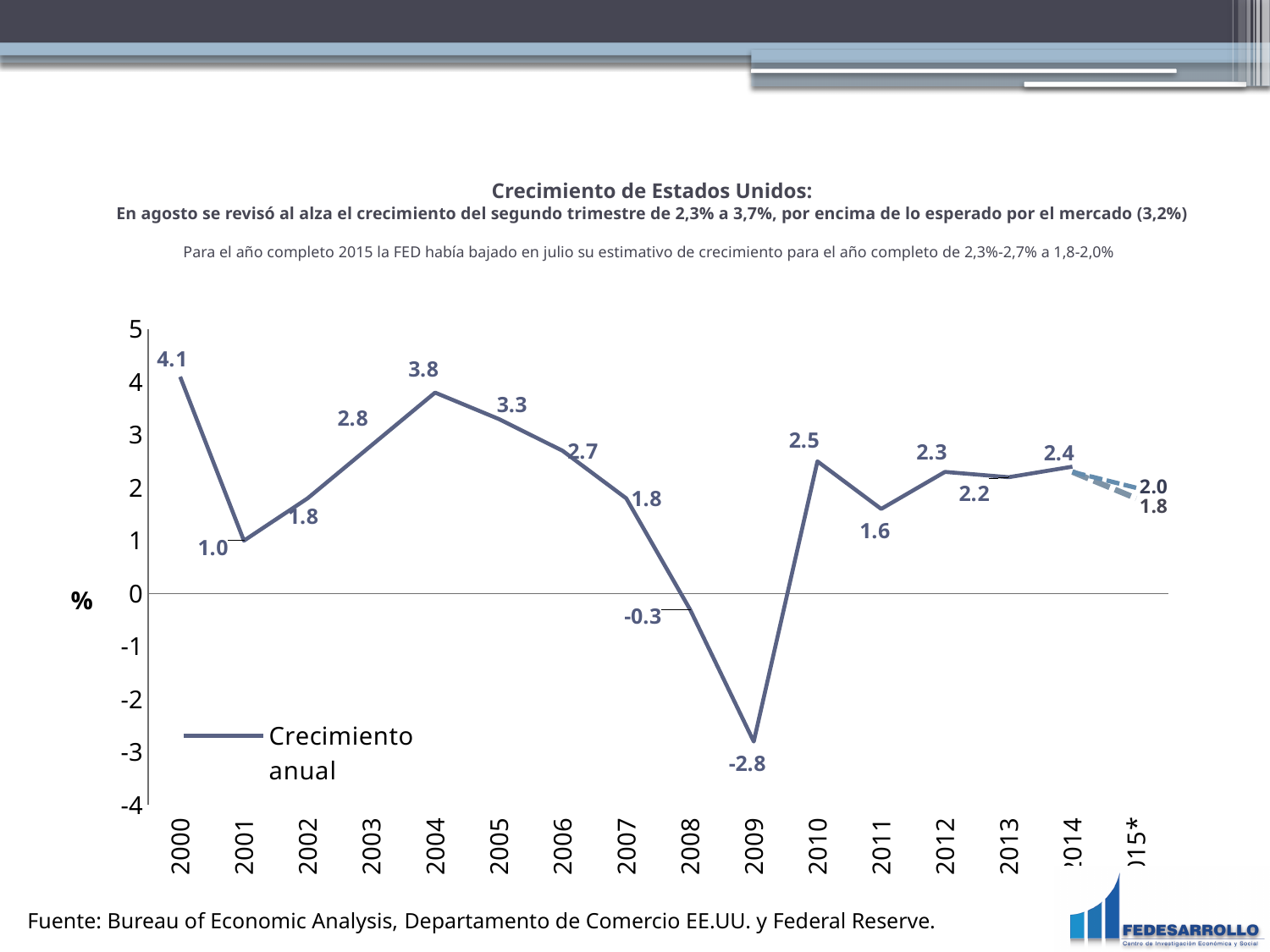
Which year has the highest value? 2000 What is the value for 2008? -0.3 What is the value for 2000? 4.1 What is the value for 2009? -2.8 Which year has the lowest value? 2009 How many years are shown on the x axis? 16 Which is larger, the value for 2003 or the value for 2006? 2003 How many series does the legend list? 1 What is the name of the series in the legend? Crecimiento anual What kind of chart is this? line chart What is the value for 2010? 2.5 What is the difference between the values for 2004 and 2005? 0.5